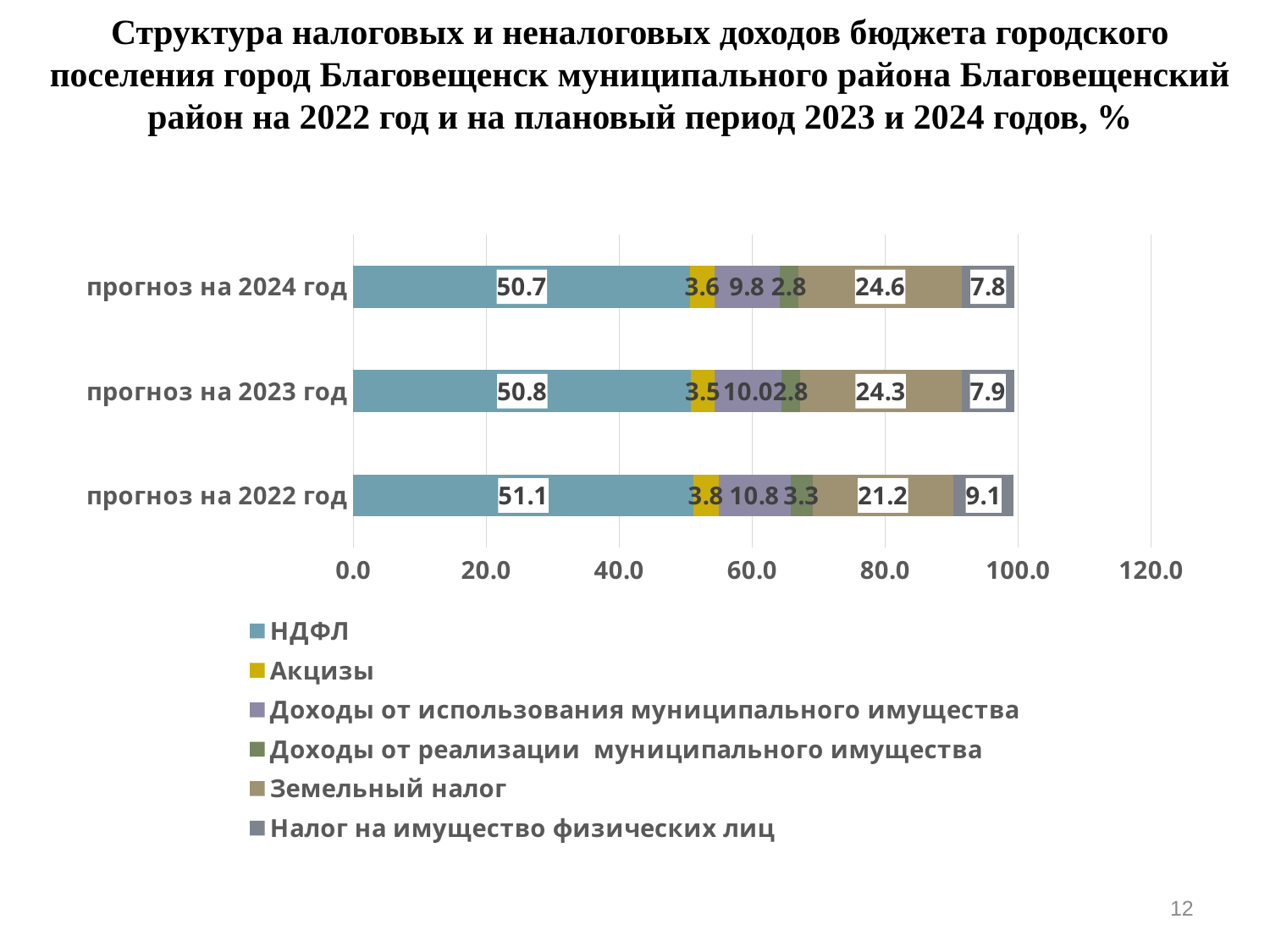
How many categories (years) are shown on the chart? 3 What is the value of Акцизы for прогноз на 2022 год? 3.8 What is the value of НДФЛ for прогноз на 2024 год? 50.7 In which year is the value of Налог на имущество физических лиц the lowest? прогноз на 2024 год What is the value of Земельный налог for прогноз на 2022 год? 21.2 How many series does the legend list? 6 What kind of chart is shown on the slide? Stacked bar chart In which year is the value of Земельный налог the highest? прогноз на 2024 год What is the value of Налог на имущество физических лиц for прогноз на 2023 год? 7.9 What is the difference between the Земельный налог values for прогноз на 2024 год and прогноз на 2022 год? 3.4 Which is larger: Доходы от использования муниципального имущества for прогноз на 2022 год or for прогноз на 2024 год? прогноз на 2022 год Which series is shown in yellow in the legend? Акцизы